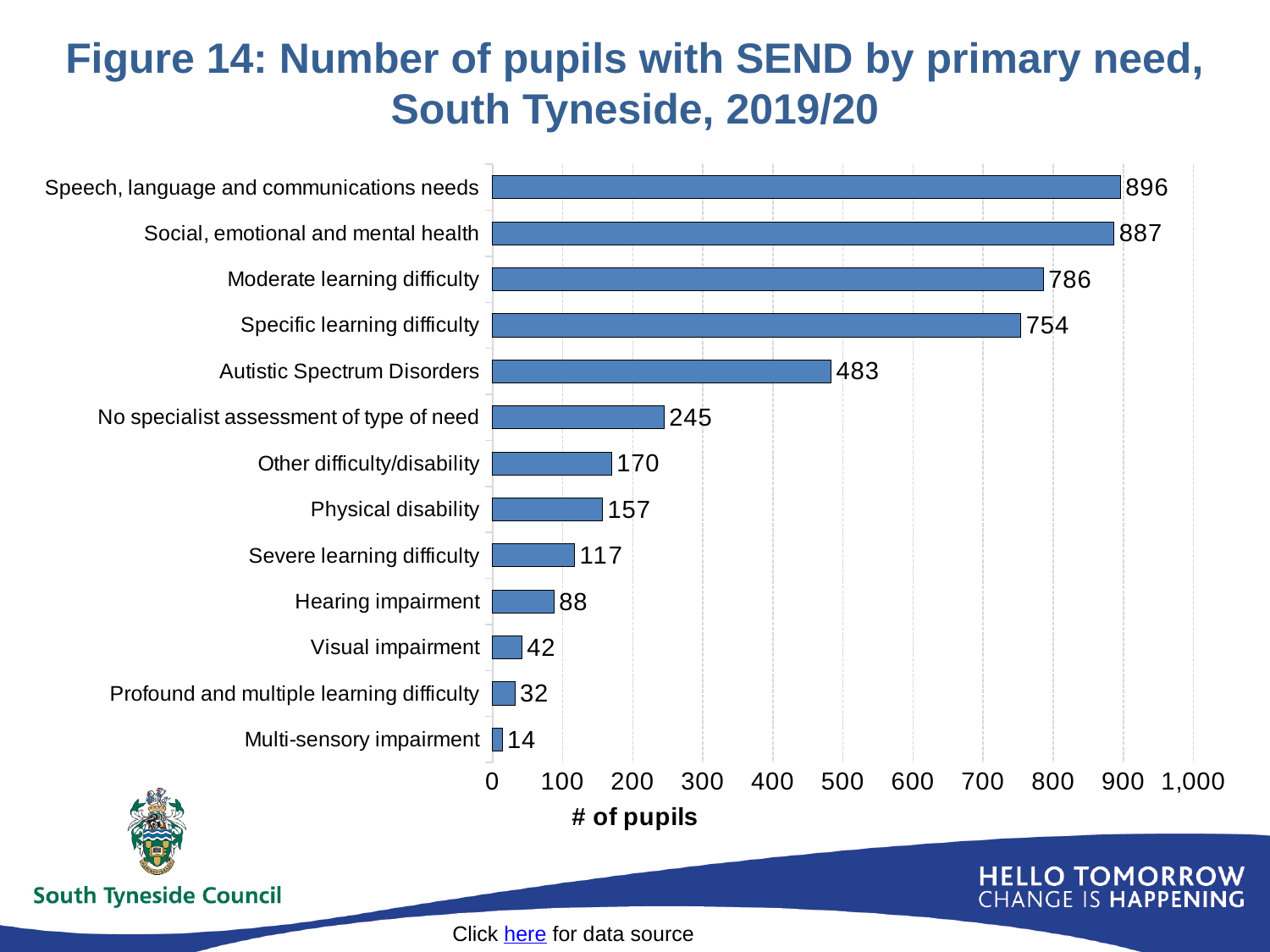
What is the difference in the number of pupils between Moderate learning difficulty and Specific learning difficulty? 32 Is the value for No specialist assessment of type of need greater or less than 200? greater Which has more pupils: Other difficulty/disability or Physical disability? Other difficulty/disability How many primary need categories are shown in the chart? 13 What kind of chart is shown on the slide? Bar chart How many pupils have Autistic Spectrum Disorders as their primary need? 483 What is the difference in the number of pupils between Speech, language and communications needs and Social, emotional and mental health? 9 What is the title of the chart? Figure 14: Number of pupils with SEND by primary need, South Tyneside, 2019/20 What is the label of the horizontal axis? # of pupils What is the number of pupils with Hearing impairment as their primary need? 88 Which primary need has the highest number of pupils? Speech, language and communications needs Which primary need has the lowest number of pupils? Multi-sensory impairment